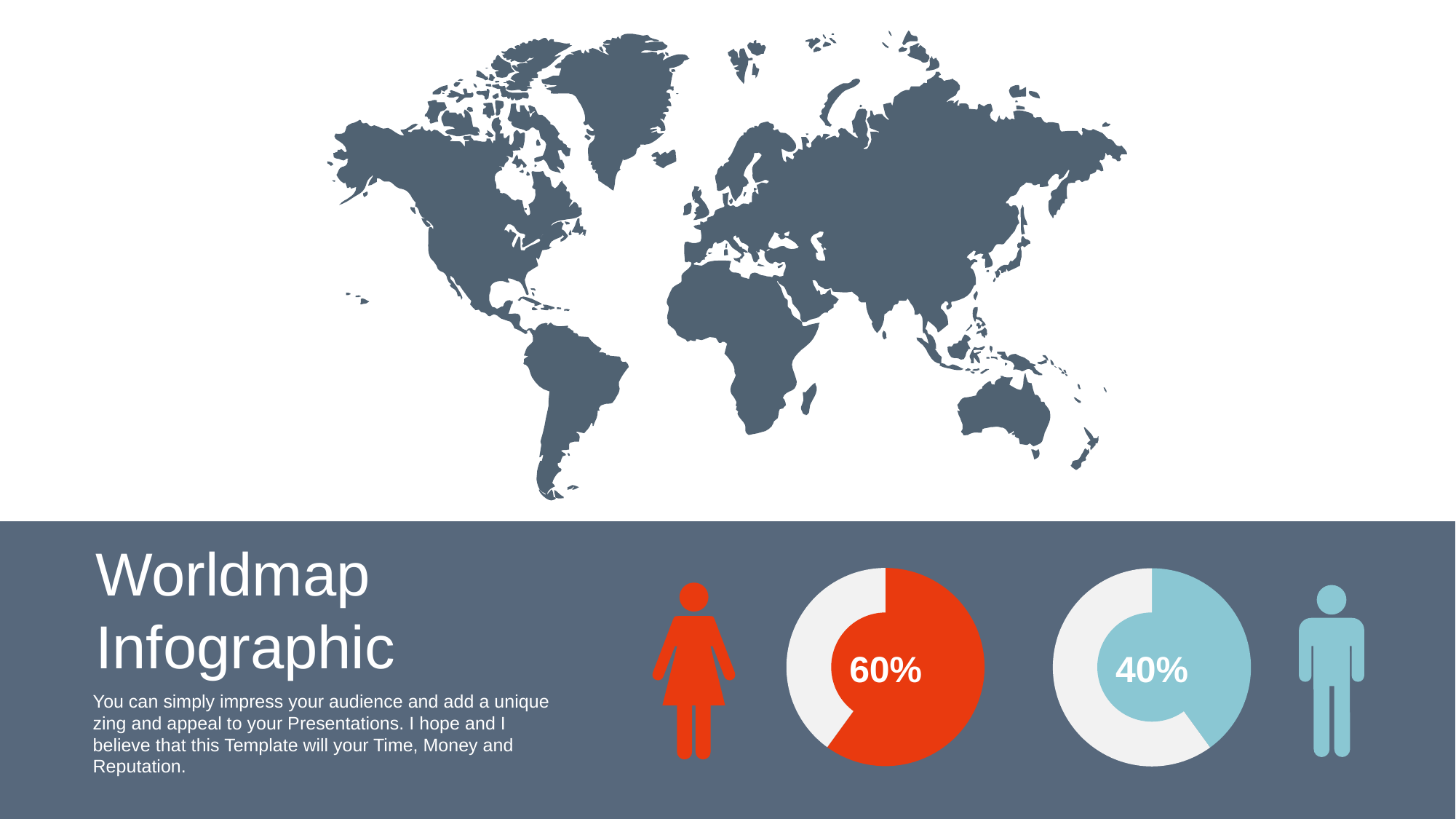
Is the value in the left pie chart (female icon) greater or less than 50%? greater How many pie charts are shown on the slide? 2 Which of the two pie charts shows the larger value, the left one (female icon) or the right one (male icon)? the left one (female icon) What is the difference between the value in the left pie chart and the value in the right pie chart? 20% What is the total of the values shown in the two pie charts? 100% What colour is the filled portion of the left pie chart showing 60%? red What value is shown in the right pie chart next to the male icon? 40% What kind of chart is used to display the 60% and 40% values? doughnut chart What colour is the filled portion of the right pie chart showing 40%? light blue What value is shown in the left pie chart next to the female icon? 60% Is the value in the right pie chart (male icon) greater or less than 50%? less